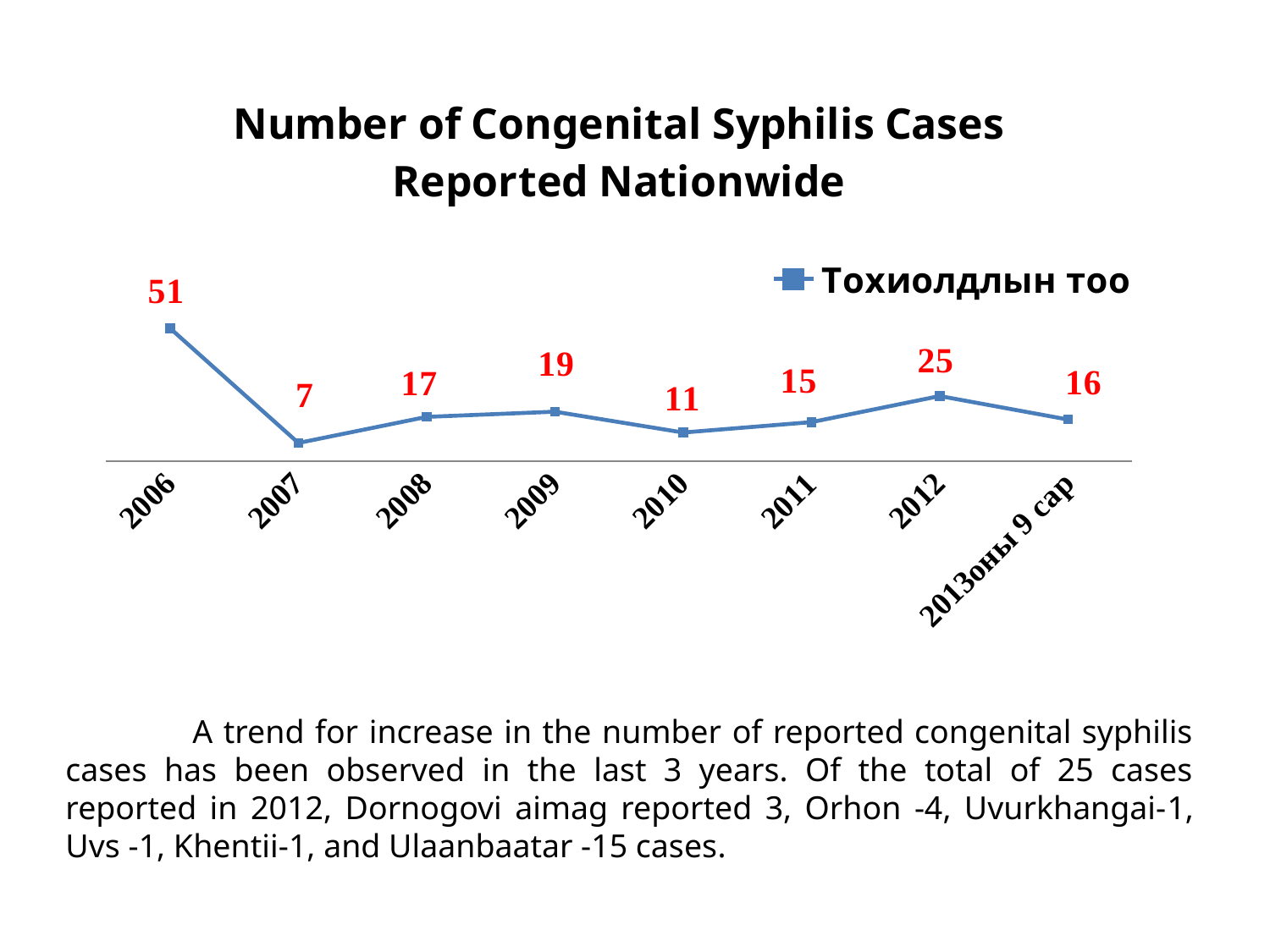
How many data points are plotted on the chart? 8 Did the number of reported cases rise or fall from 2010 to 2012? Rise What is the number of congenital syphilis cases reported in 2009? 19 What is the difference between the number of cases in 2012 and 2011? 10 What kind of chart is shown on the slide? Line chart Which year has the lowest number of reported congenital syphilis cases? 2007 What is the number of congenital syphilis cases reported in 2012? 25 Which year had more reported cases, 2010 or 2011? 2011 What is the number of congenital syphilis cases reported in 2006? 51 Which year has the highest number of reported congenital syphilis cases? 2006 How many series does the legend list? 1 What is the difference between the number of cases in 2006 and 2007? 44